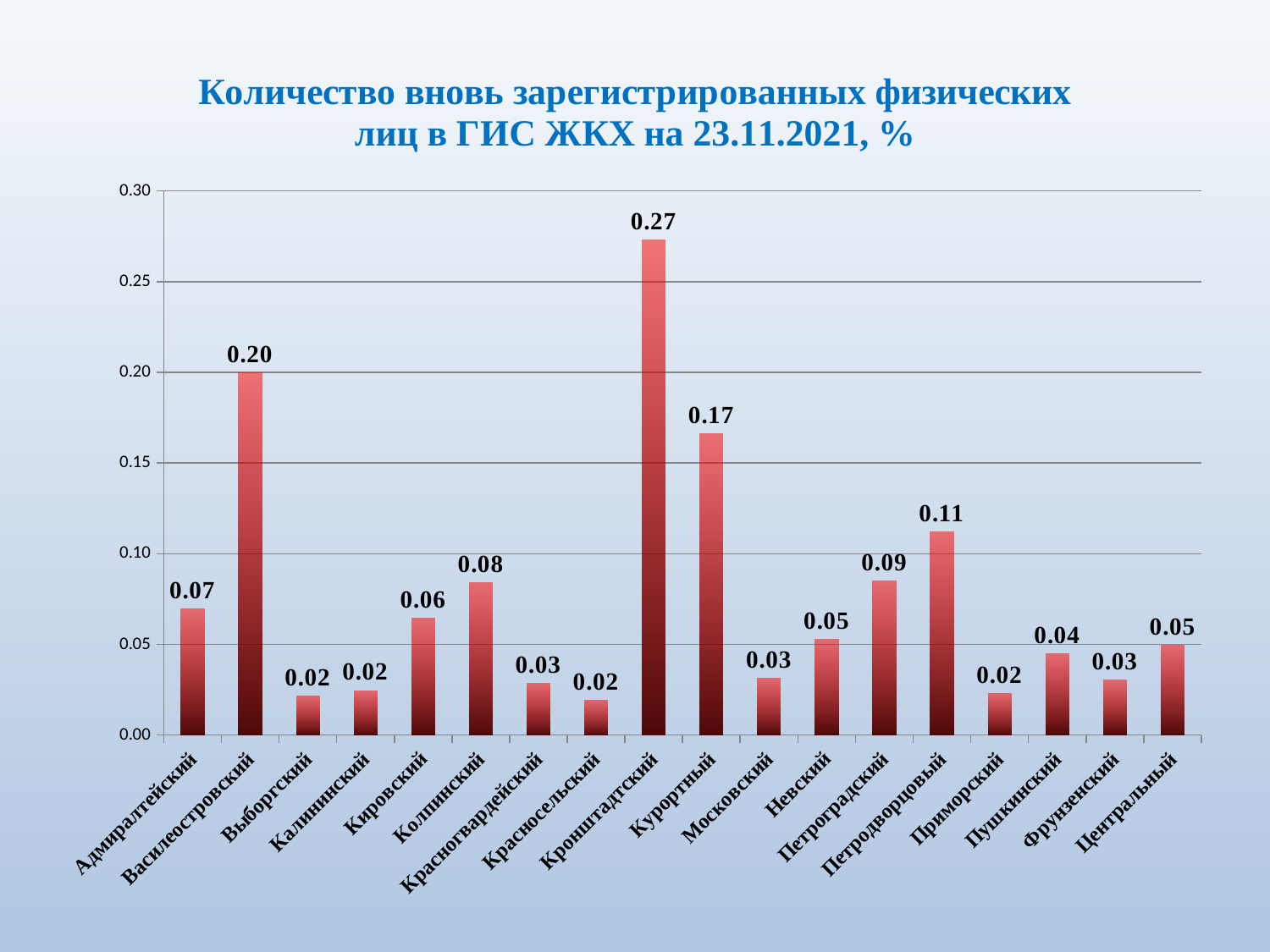
Which district has the highest value? Кронштадтский What is the difference between the values for Кронштадтский and Василеостровский? 0.07 Is the value for Кронштадтский greater or less than 0.25? greater What is the value for Василеостровский? 0.20 What is the value for Петродворцовый? 0.11 What kind of chart is shown on the slide? bar chart What is the value for Пушкинский? 0.04 What is the difference between the values for Курортный and Петроградский? 0.08 What is the value for Кронштадтский? 0.27 Which is larger, the value for Курортный or the value for Петродворцовый? Курортный How many districts are shown on the x axis? 18 What date is given in the chart title? 23.11.2021